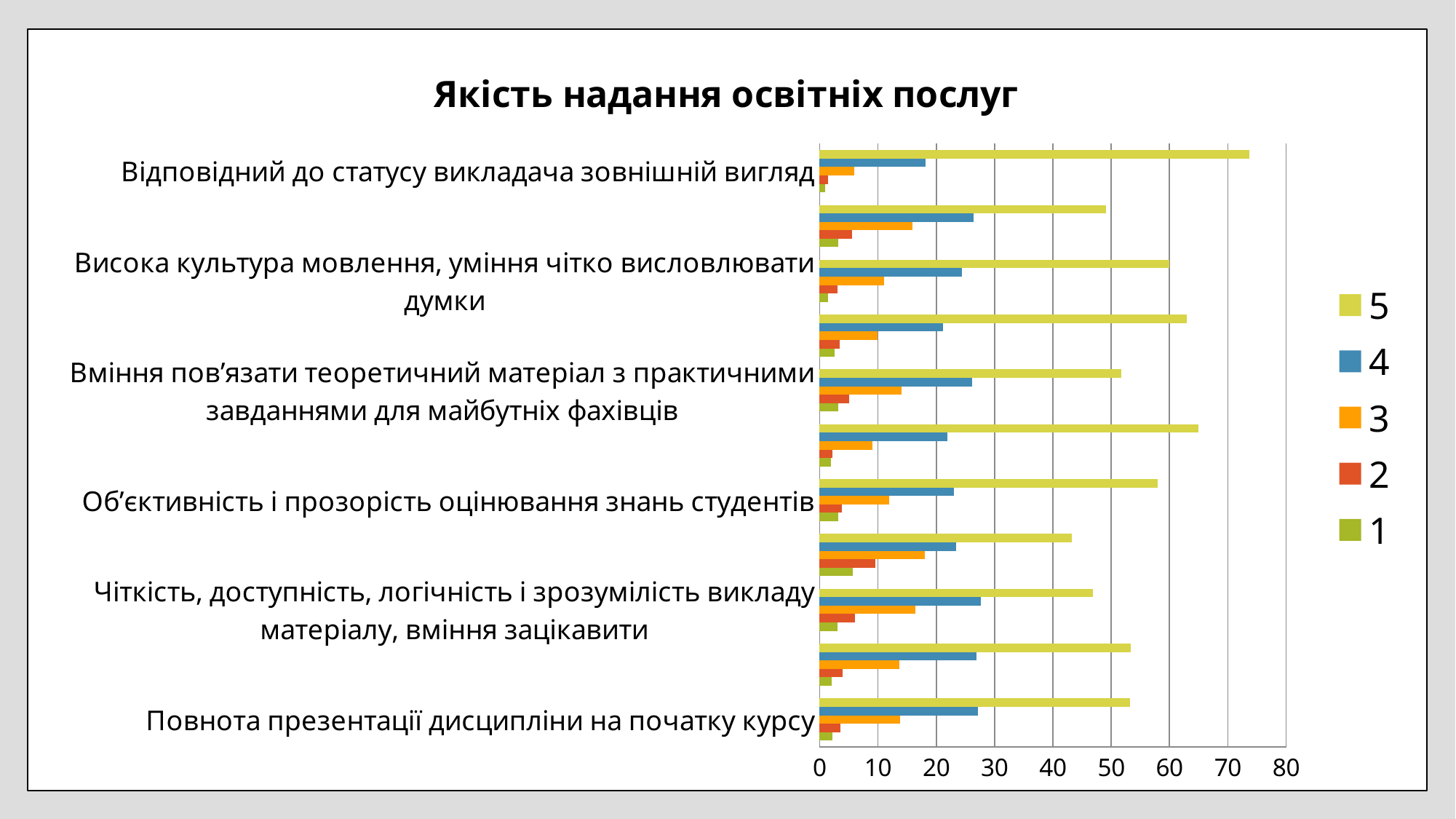
Is the value of series 3 for "Відповідний до статусу викладача зовнішній вигляд" greater or less than 10? less For series 5, which is larger: "Висока культура мовлення, уміння чітко висловлювати думки" or "Вміння пов’язати теоретичний матеріал з практичними завданнями для майбутніх фахівців"? Висока культура мовлення, уміння чітко висловлювати думки What kind of chart is shown on the slide? bar chart Is the value of series 5 for "Відповідний до статусу викладача зовнішній вигляд" greater or less than 70? greater What is the title of the chart? Якість надання освітніх послуг What are the legend entries of the chart? 5, 4, 3, 2, 1 How many series does the legend list? 5 Which labeled category has the highest value for series 5? Відповідний до статусу викладача зовнішній вигляд For "Повнота презентації дисципліни на початку курсу", which series has the larger value: 5 or 4? 5 Is the value of series 5 for "Чіткість, доступність, логічність і зрозумілість викладу матеріалу, вміння зацікавити" greater or less than 50? less